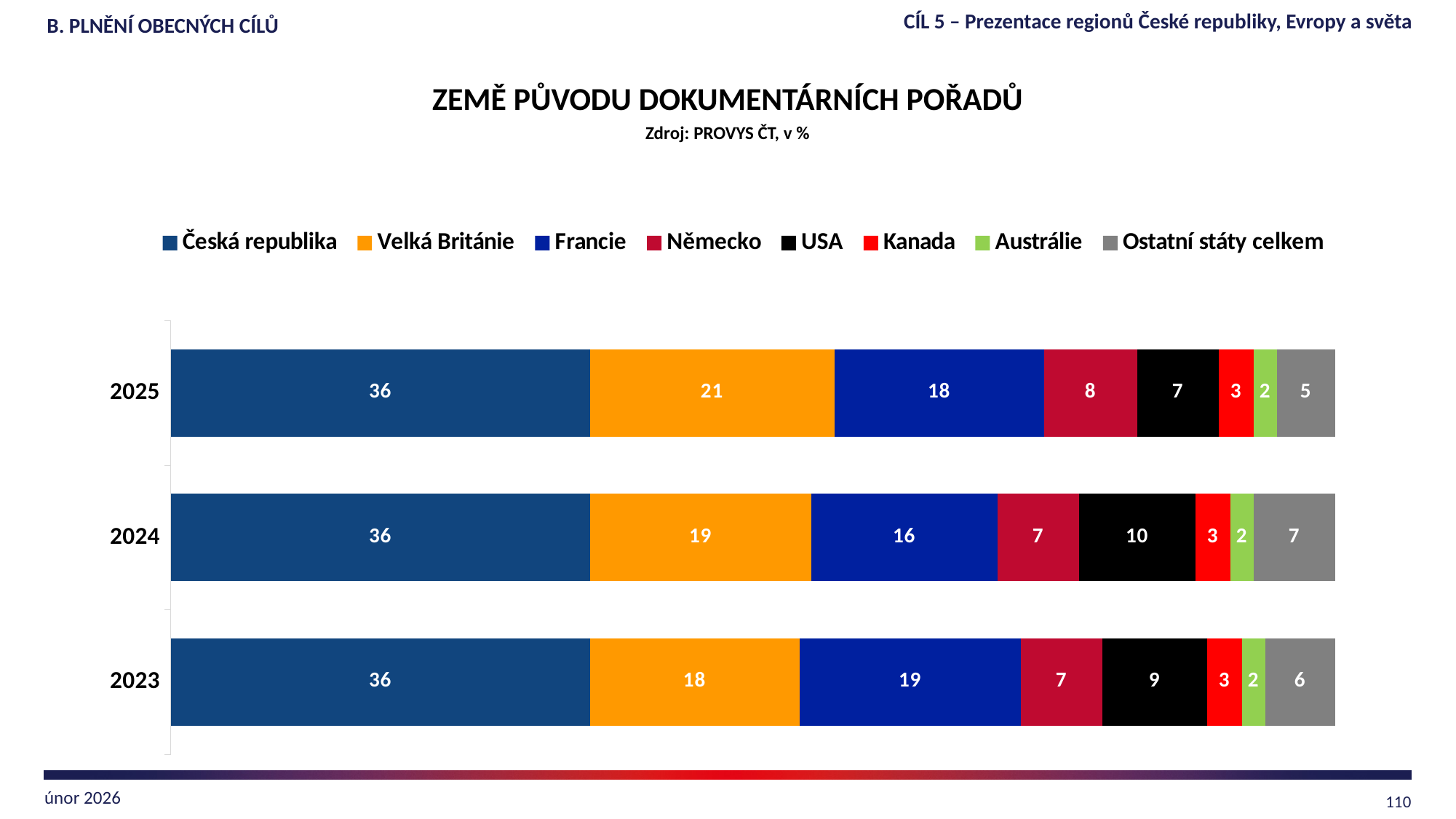
What is the value for Ostatní státy celkem in 2025? 5 What is the value for Francie in 2023? 19 Which is larger in 2023: the value for Francie or the value for Velká Británie? Francie What is the total of the stacked bar for 2024? 100 What is the value for USA in 2024? 10 What type of chart is shown on the slide? stacked bar chart What is the value for Velká Británie in 2025? 21 Which country has the highest value in 2025? Česká republika Which series has the lowest value in 2024? Austrálie How many years (categories) are shown on the chart? 3 What is the difference between the values for Velká Británie and Francie in 2025? 3 How many series does the legend list? 8